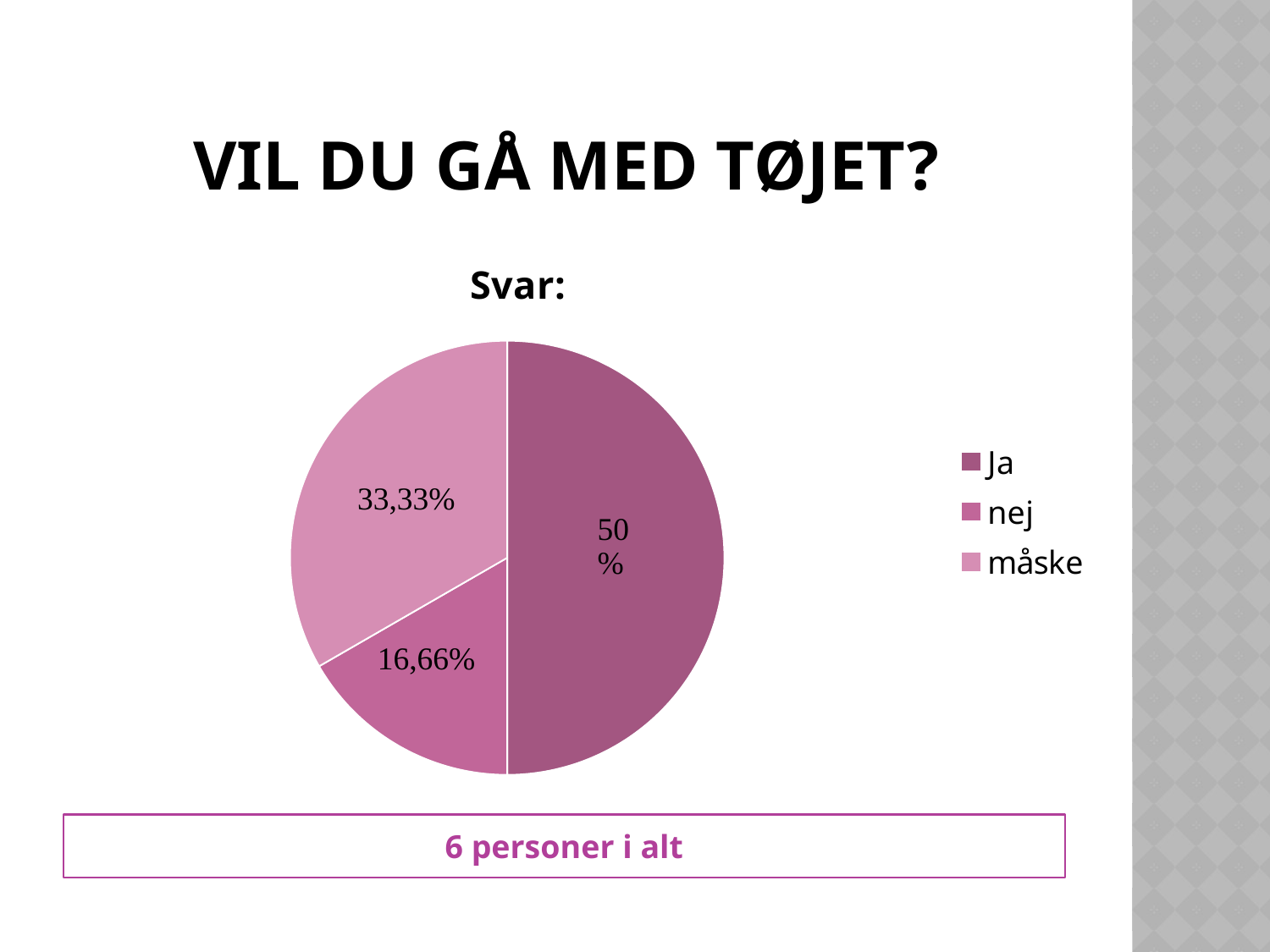
How many entries does the legend list? 3 What is the difference in percentage points between the "Ja" slice and the "måske" slice? 16,67 What is the title of the chart? Svar: How many slices does the pie chart have? 3 Which answer has the smallest slice of the pie? nej What share of the pie does the "Ja" slice represent? 50% Which answer has the largest slice of the pie? Ja What kind of chart is shown on the slide? pie chart What share of the pie does the "nej" slice represent? 16,66% Which slice is larger, "måske" or "nej"? måske What share of the pie does the "måske" slice represent? 33,33% How many people in total answered, according to the text below the chart? 6 personer i alt